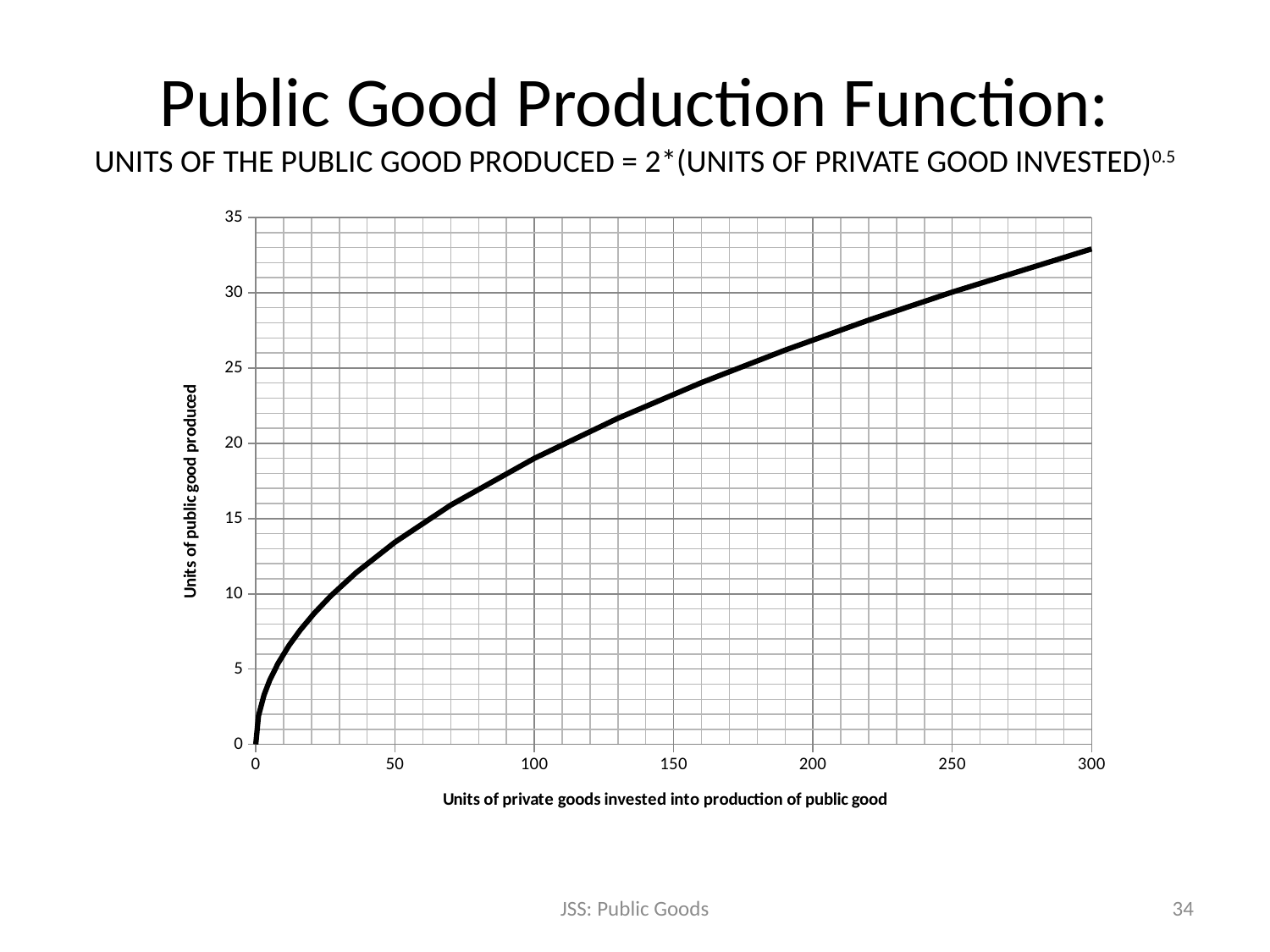
What is the label of the x axis of the chart? Units of private goods invested into production of public good Is the value of public good produced at 200 units of private goods invested greater or less than 25? greater How many units of public good are produced when 0 units of private goods are invested? 0 Is the value of public good produced at 50 units of private goods invested greater or less than 10? greater Is the value of public good produced at 50 units of private goods invested greater or less than 15? less Which is larger: the units of public good produced at 100 units invested or at 250 units invested? 250 units invested Do the units of public good produced rise or fall as the units of private goods invested increase? rise What kind of chart is shown on the slide? line chart